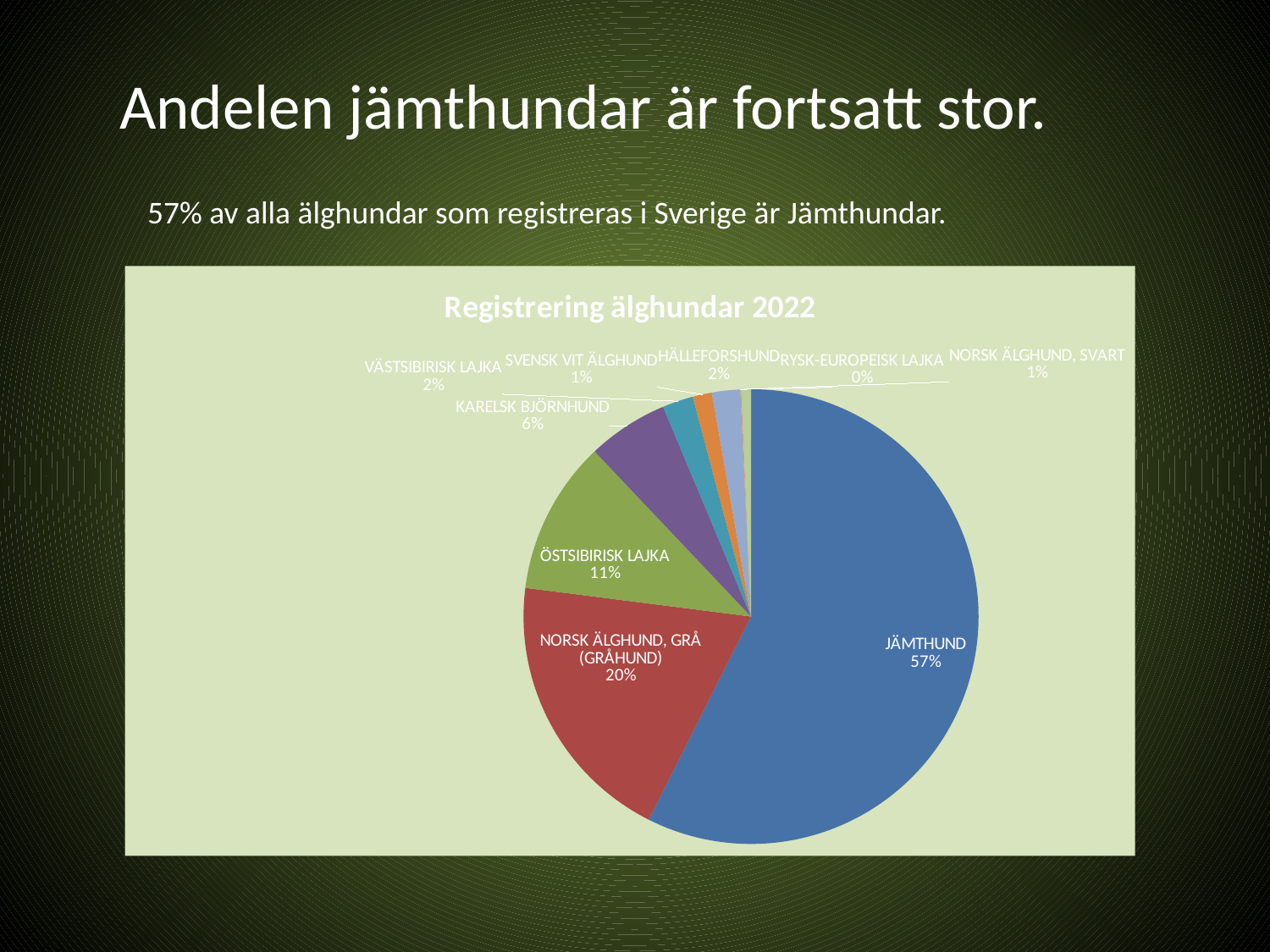
What share of the pie does HÄLLEFORSHUND have? 2% What share of the pie does ÖSTSIBIRISK LAJKA have? 11% Which category has the largest slice of the pie? JÄMTHUND What is the title of the chart? Registrering älghundar 2022 Which category has the smallest slice of the pie? RYSK-EUROPEISK LAJKA What share of the pie does JÄMTHUND have? 57% Which is larger, the share for ÖSTSIBIRISK LAJKA or the share for KARELSK BJÖRNHUND? ÖSTSIBIRISK LAJKA How many categories are shown in the pie chart? 9 What is the difference in percentage points between JÄMTHUND and NORSK ÄLGHUND, GRÅ (GRÅHUND)? 37 percentage points What kind of chart is shown on the slide? pie chart